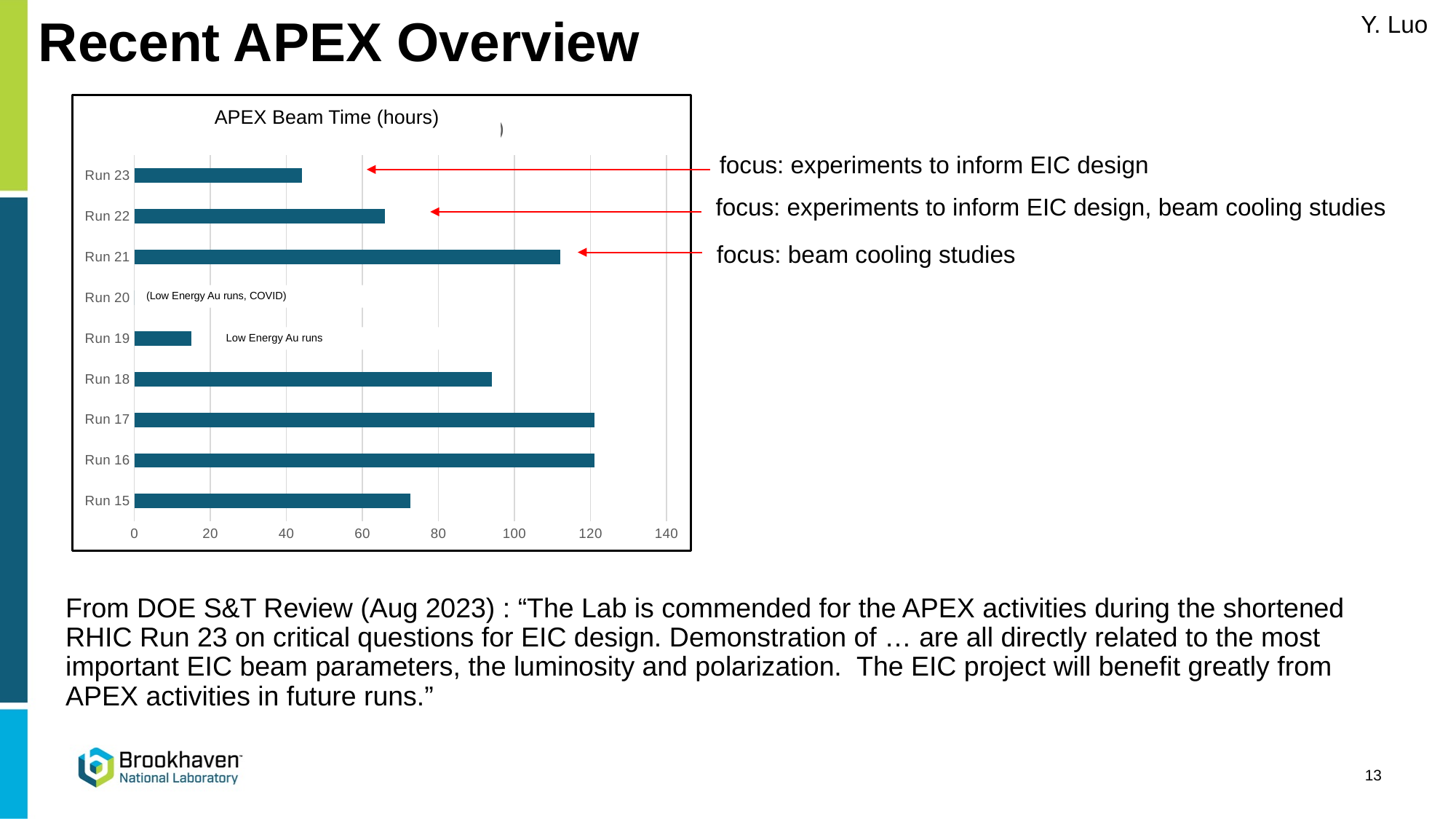
Is the value for Run 22 greater or less than 80? less Is the value for Run 18 greater or less than 80? greater What kind of chart is shown on the slide? bar chart How many runs are listed on the vertical axis of the chart? 9 Which has the larger value, Run 18 or Run 15? Run 18 Among the runs with a plotted bar, which run has the lowest value? Run 19 What is the title of the chart? APEX Beam Time (hours) Which run has no bar plotted and is annotated with "(Low Energy Au runs, COVID)"? Run 20 Which has the larger value, Run 21 or Run 22? Run 21 Is the value for Run 23 greater or less than 60? less